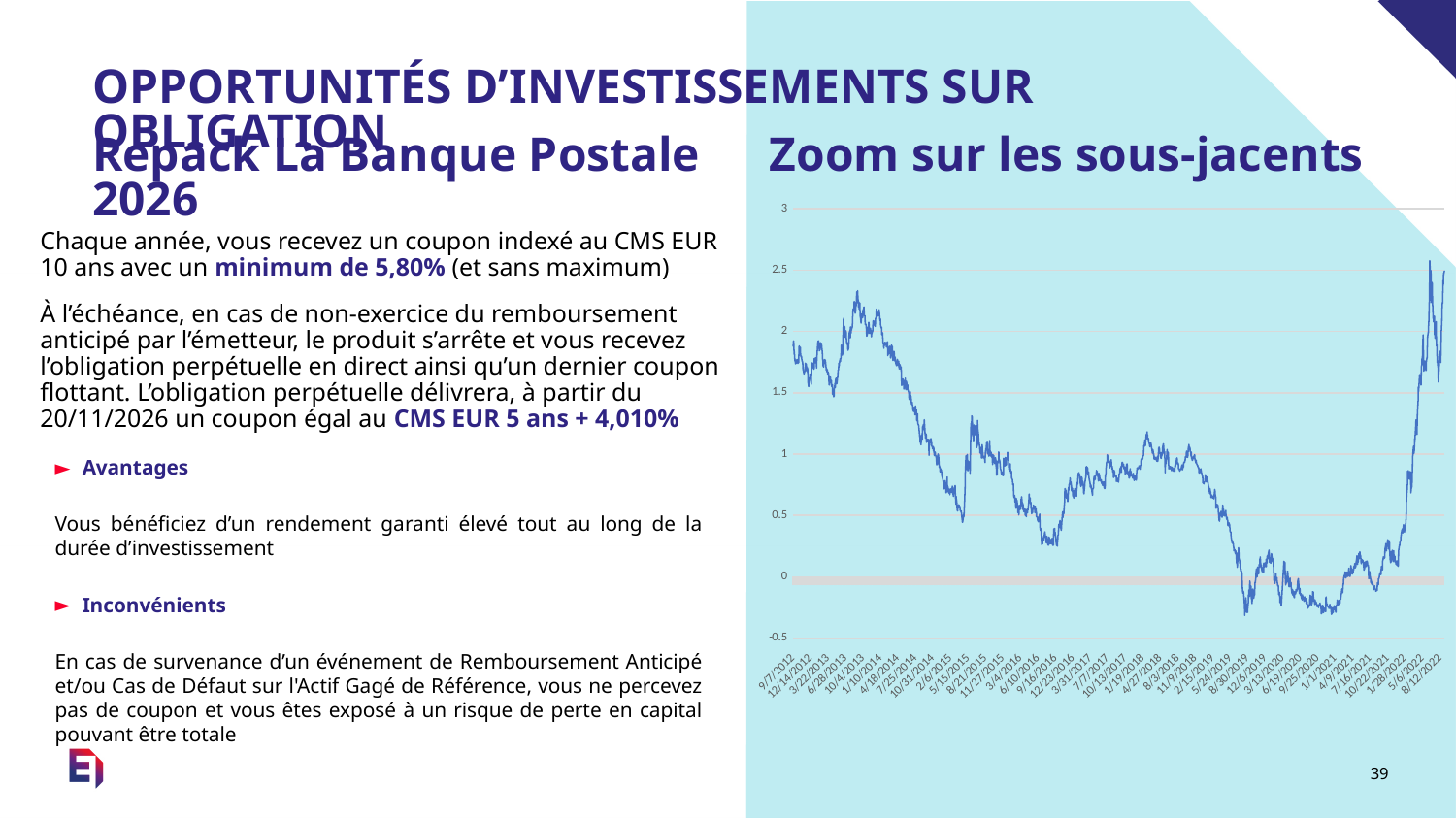
Is the value of the line at 9/7/2012 greater or less than 1.5? greater Is the value of the line at 8/12/2022 greater or less than 2? less Which is larger: the value of the line at 8/12/2022 or at 3/13/2020? 8/12/2022 What is the highest value shown on the chart's vertical axis? 3 How many lines are plotted on the chart? 1 What kind of chart is shown on the right side of the slide under "Zoom sur les sous-jacents"? line chart What is the lowest value shown on the chart's vertical axis? -0.5 Which is larger: the value of the line at 9/7/2012 or at 12/6/2019? 9/7/2012 Is the value of the line at 9/16/2016 greater or less than 1? less Does the line rise or fall between 9/25/2020 and 8/12/2022? rise Does the line rise or fall between 9/7/2012 and 12/6/2019? fall